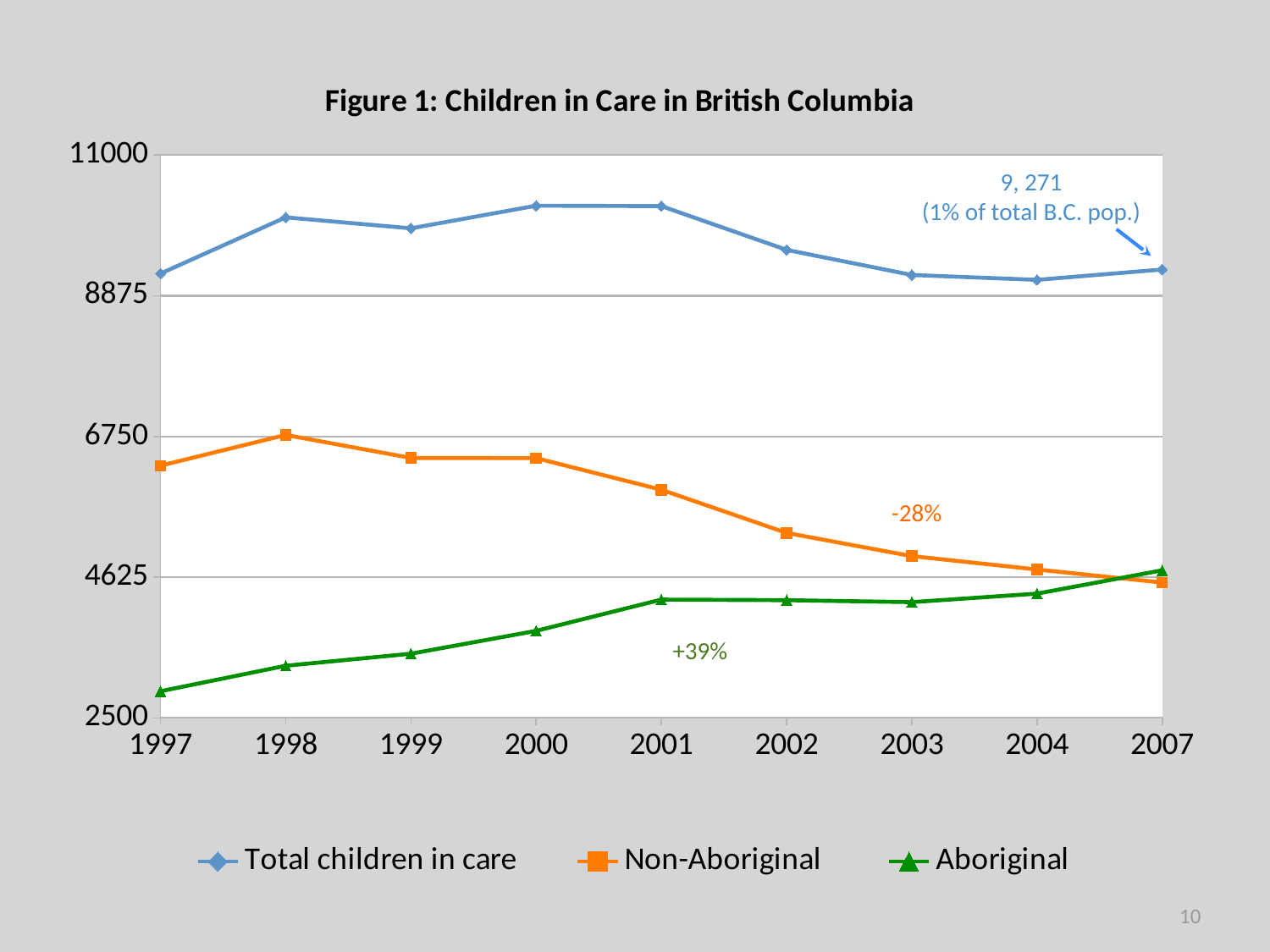
How many years are plotted along the x axis? 9 Is the value for Non-Aboriginal in 1997 greater or less than 6750? less In which year is the Aboriginal series at its lowest? 1997 In 2001, which is larger: Non-Aboriginal or Aboriginal? Non-Aboriginal What is the labelled value for Total children in care in 2007? 9, 271 Is the value for Total children in care in 2000 greater or less than 8875? greater Is the value for Aboriginal in 2001 greater or less than 4625? less In which year is the Non-Aboriginal series at its highest? 1998 What kind of chart is shown on the slide? line chart How many series does the legend list? 3 Does the Aboriginal series rise or fall from 1997 to 2007? rise In which year is the Non-Aboriginal series at its lowest? 2007